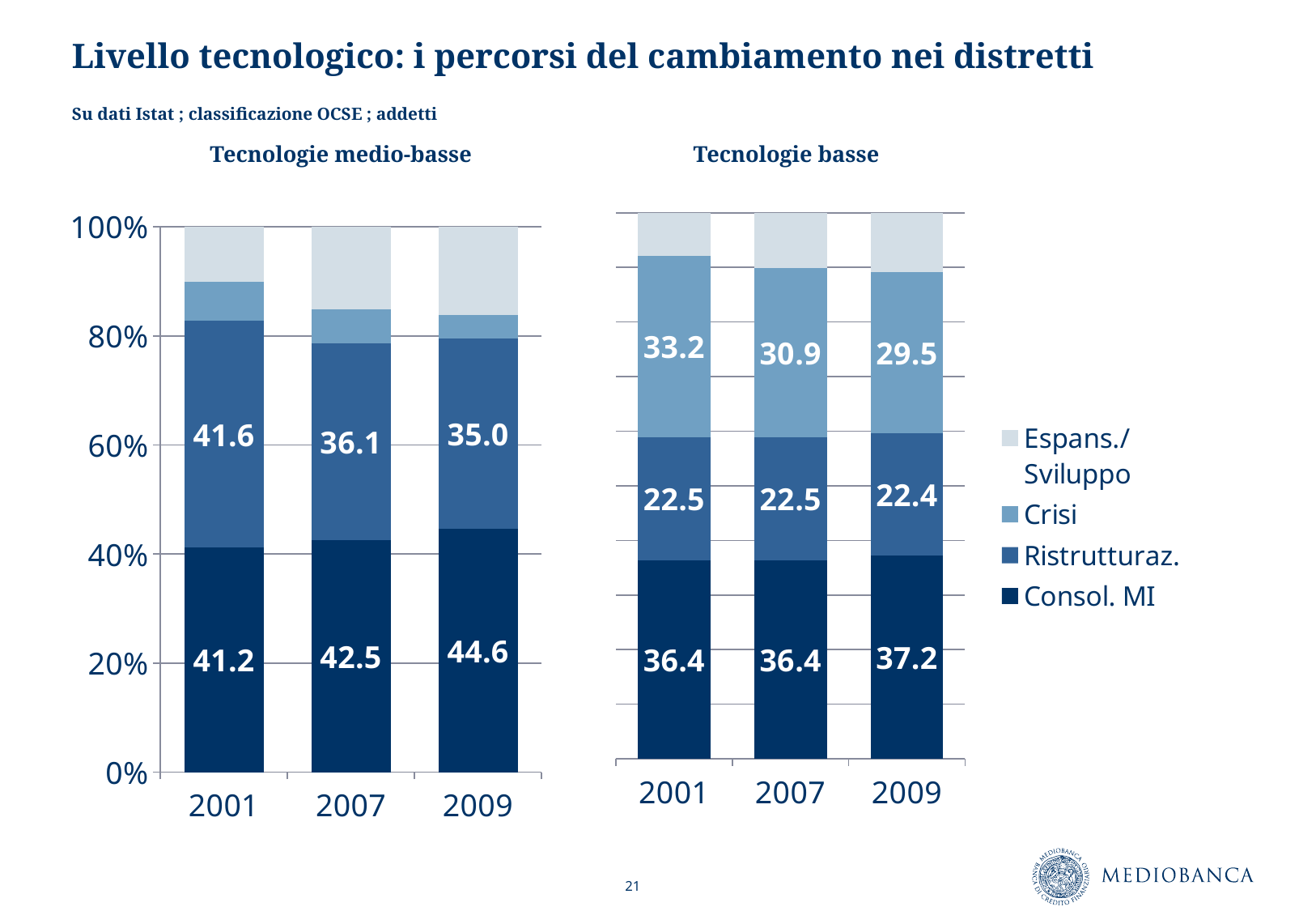
In the 'Tecnologie medio-basse' chart, in which year is the Consol. MI value highest? 2009 In the 'Tecnologie medio-basse' chart, what is the value of Consol. MI in 2009? 44.6 In the 'Tecnologie medio-basse' chart, which is larger in 2007: Consol. MI or Ristrutturaz.? Consol. MI In the 'Tecnologie medio-basse' chart, what is the difference between the Ristrutturaz. values in 2001 and 2009? 6.6 In the 'Tecnologie basse' chart, what is the value of Ristrutturaz. in 2009? 22.4 In the 'Tecnologie medio-basse' chart, what is the value of Ristrutturaz. in 2001? 41.6 In the 'Tecnologie basse' chart, in which year is the Crisi value lowest? 2009 In the 'Tecnologie basse' chart, what is the value of Crisi in 2007? 30.9 What kind of chart is the 'Tecnologie basse' chart? stacked bar chart In the 'Tecnologie basse' chart, does the Crisi value rise or fall from 2001 to 2009? fall In the 'Tecnologie basse' chart, what is the difference between the Crisi values in 2001 and 2009? 3.7 How many series does the legend list? 4